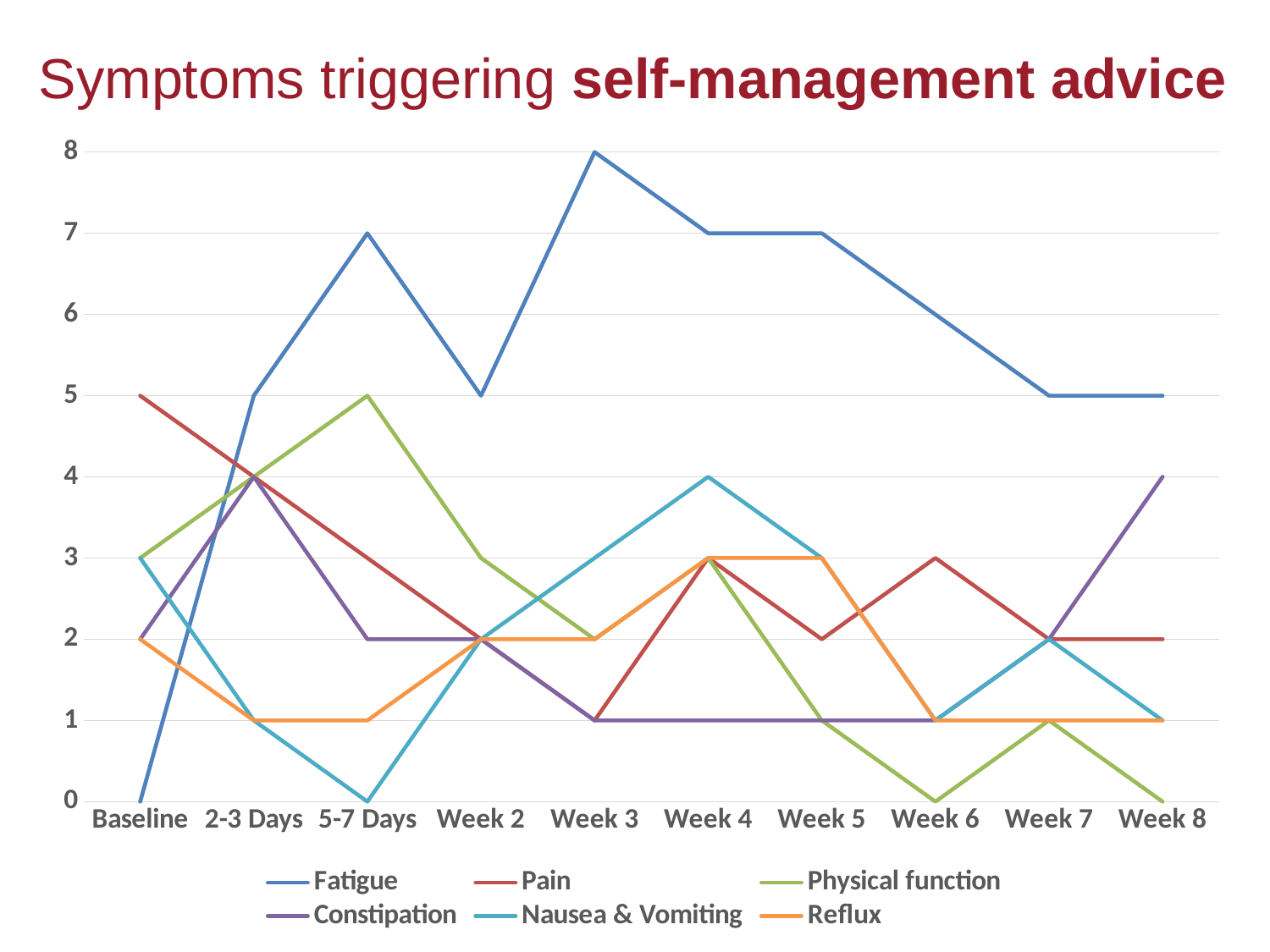
How many series does the legend list? 6 At which time point does Fatigue reach its highest value? Week 3 What kind of chart is shown on the slide? Line chart Which is larger at Week 8: Constipation or Pain? Constipation What is the difference between the Fatigue value at Week 3 and the Fatigue value at Week 8? 3 What is the value for Nausea & Vomiting at Week 4? 4 What is the value for Pain at Baseline? 5 Which series has the lowest value at Baseline? Fatigue What is the title of the chart? Symptoms triggering self-management advice What is the value for Fatigue at Week 3? 8 How many time points are shown along the x axis? 10 Does the Physical function line rise or fall from 5-7 Days to Week 8? Fall